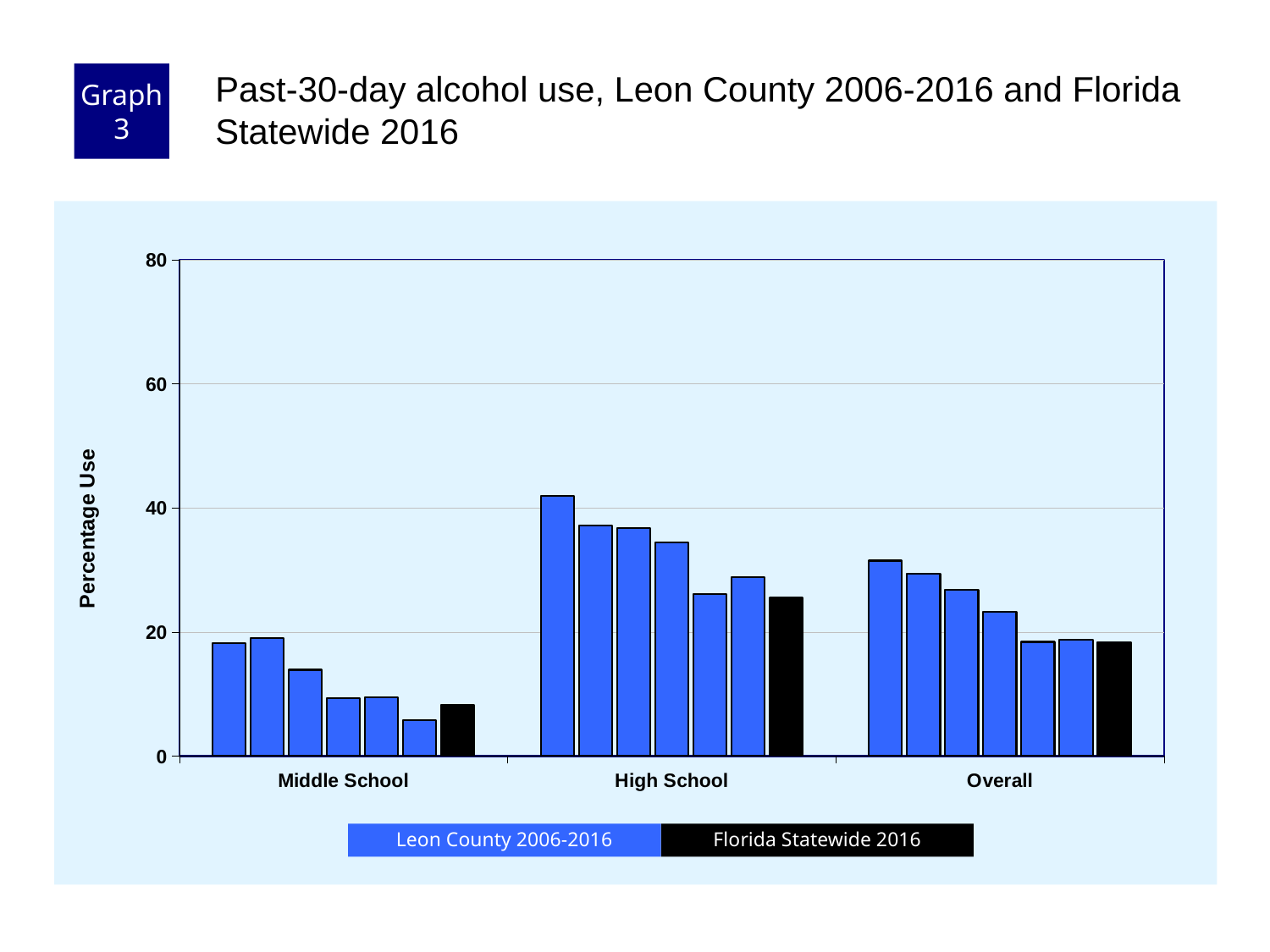
How many series does the legend list? 2 Is the tallest Leon County bar for High School greater or less than 40? greater Which category has the lowest bars overall? Middle School Which is larger, the Florida Statewide 2016 value for High School or for Middle School? High School Is the Florida Statewide 2016 value for High School greater or less than 20? greater What is the label on the y axis? Percentage Use Do the Leon County 2006-2016 bars within the High School group rise or fall from left to right? fall Which category has the highest bars overall? High School How many categories are shown on the x axis? 3 Is the tallest Leon County bar for Overall greater or less than 40? less What kind of chart is shown on the slide? bar chart